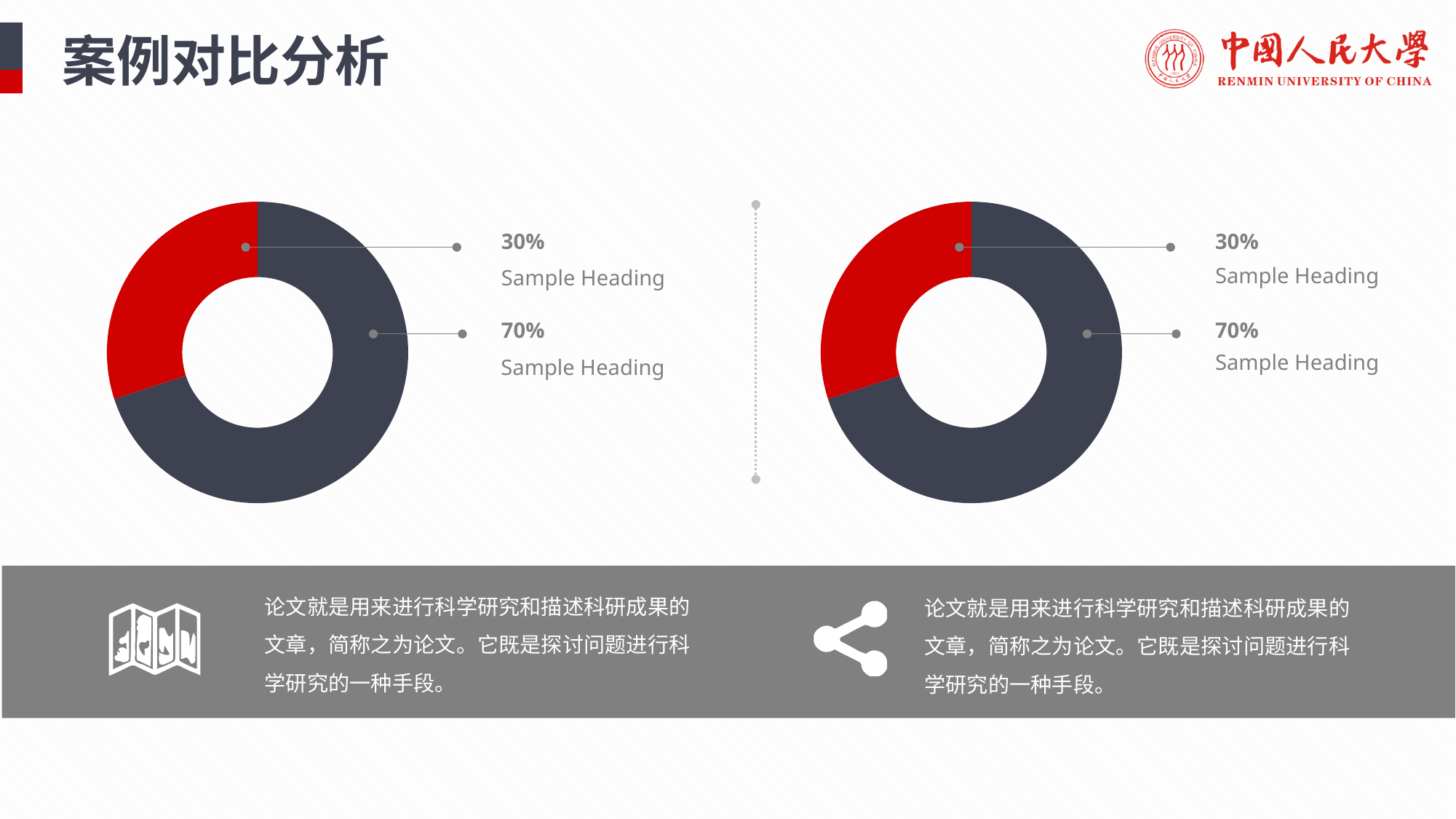
Is the value of the red slice in the left chart larger, smaller, or the same as the red slice in the right chart? the same In the right chart, what value is labelled for the dark grey slice? 70% In the left chart, what is the difference between the 70% slice and the 30% slice? 40 percentage points In the left chart, which slice is the largest? the dark grey slice (70%) In the left chart, what value is labelled for the red slice? 30% How many slices does the left chart have? 2 In the right chart, what do the two labelled slice values add up to? 100% What kind of chart is shown on the left side of the slide? doughnut chart In the right chart, which slice is the smallest? the red slice (30%) In the right chart, is the dark grey slice greater or less than 50% of the whole? greater In the left chart, what colour is the slice labelled 30%? red In the right chart, which is larger, the red slice or the dark grey slice? the dark grey slice